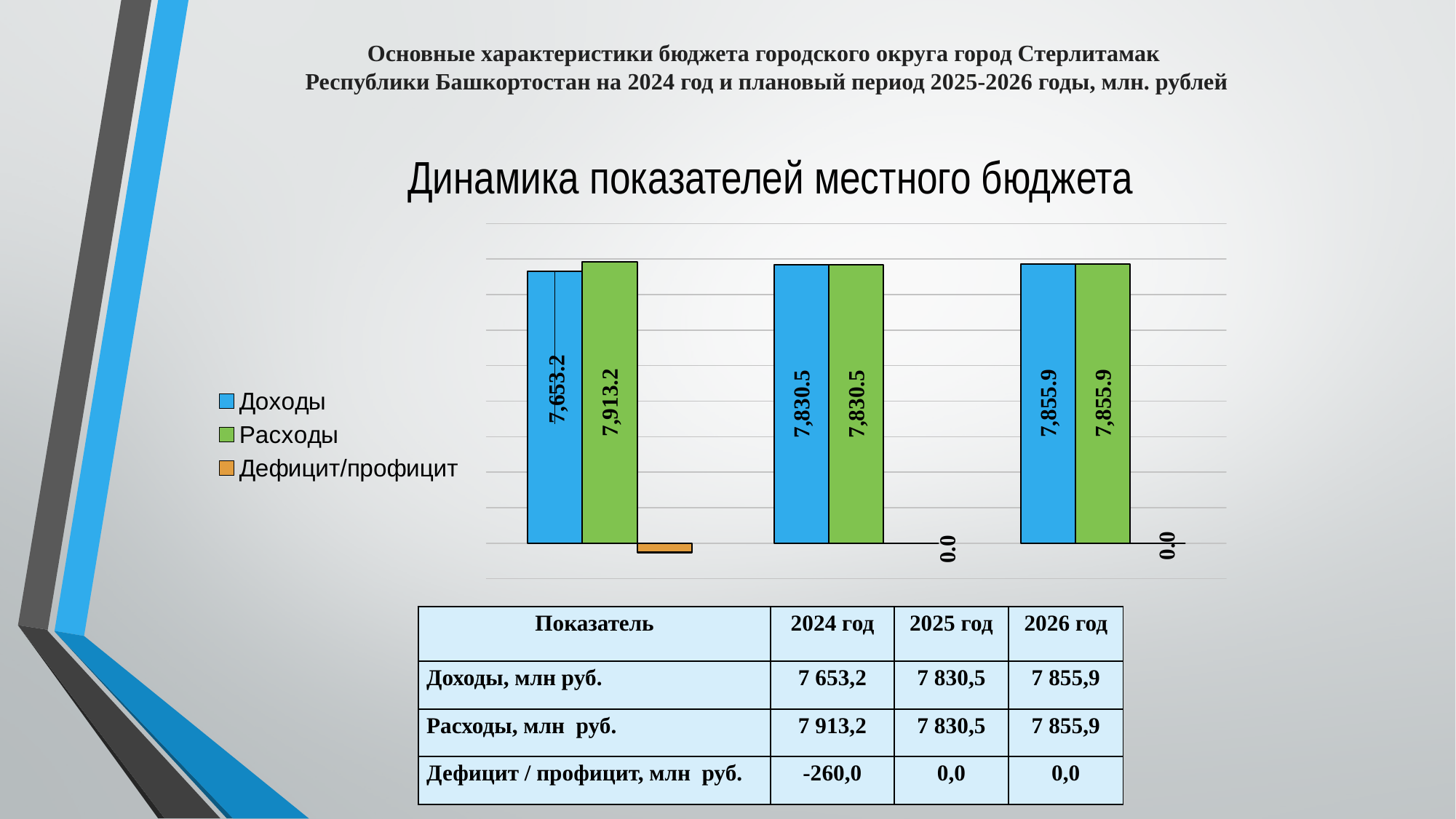
What is the value of the Доходы bar in the second (middle) group? 7,830.5 What is the difference between the Расходы and Доходы values in the first (leftmost) group? 260.0 What is the value of the Дефицит/профицит series in the third (rightmost) group? 0.0 What is the chart's title? Динамика показателей местного бюджета What is the value of the Расходы bar in the first (leftmost) group? 7,913.2 Which colour represents the Дефицит/профицит series in the legend? orange What type of chart is shown on the slide? bar chart What is the value of the Доходы bar in the first (leftmost) group? 7,653.2 How many groups of bars are plotted in the chart? 3 How many series does the legend list? 3 In the first (leftmost) group, which is larger, the Доходы bar or the Расходы bar? Расходы What is the value of the Расходы bar in the third (rightmost) group? 7,855.9